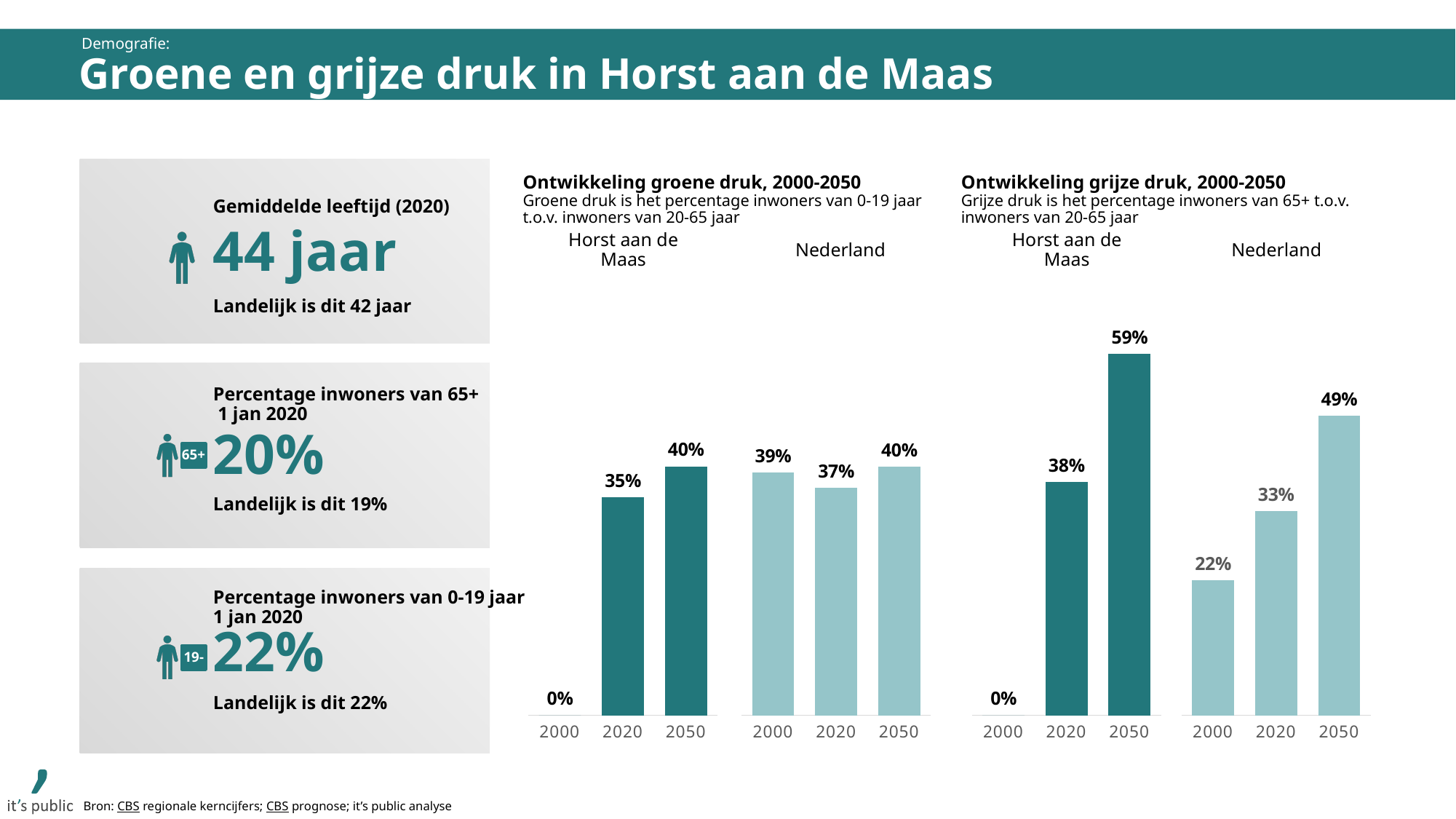
In the chart 'Ontwikkeling groene druk, 2000-2050', what is the value for Horst aan de Maas in 2020? 35% In the chart 'Ontwikkeling grijze druk, 2000-2050', what is the value for Nederland in 2020? 33% What type of chart is 'Ontwikkeling groene druk, 2000-2050'? bar chart In the chart 'Ontwikkeling grijze druk, 2000-2050', do the values for Nederland rise or fall from 2000 to 2050? rise In the chart 'Ontwikkeling groene druk, 2000-2050', what is the value for Nederland in 2000? 39% In the chart 'Ontwikkeling grijze druk, 2000-2050', what is the difference between Horst aan de Maas and Nederland in 2050? 10% In the chart 'Ontwikkeling grijze druk, 2000-2050', how many bars are shown for Nederland? 3 In the chart 'Ontwikkeling grijze druk, 2000-2050', which bar has the highest value? Horst aan de Maas 2050 In the chart 'Ontwikkeling grijze druk, 2000-2050', what is the value for Horst aan de Maas in 2050? 59% In the chart 'Ontwikkeling grijze druk, 2000-2050', which is larger in 2020: Horst aan de Maas or Nederland? Horst aan de Maas In the chart 'Ontwikkeling groene druk, 2000-2050', what is the difference between Nederland in 2000 and Nederland in 2020? 2% In the chart 'Ontwikkeling groene druk, 2000-2050', which is larger in 2020: Horst aan de Maas or Nederland? Nederland